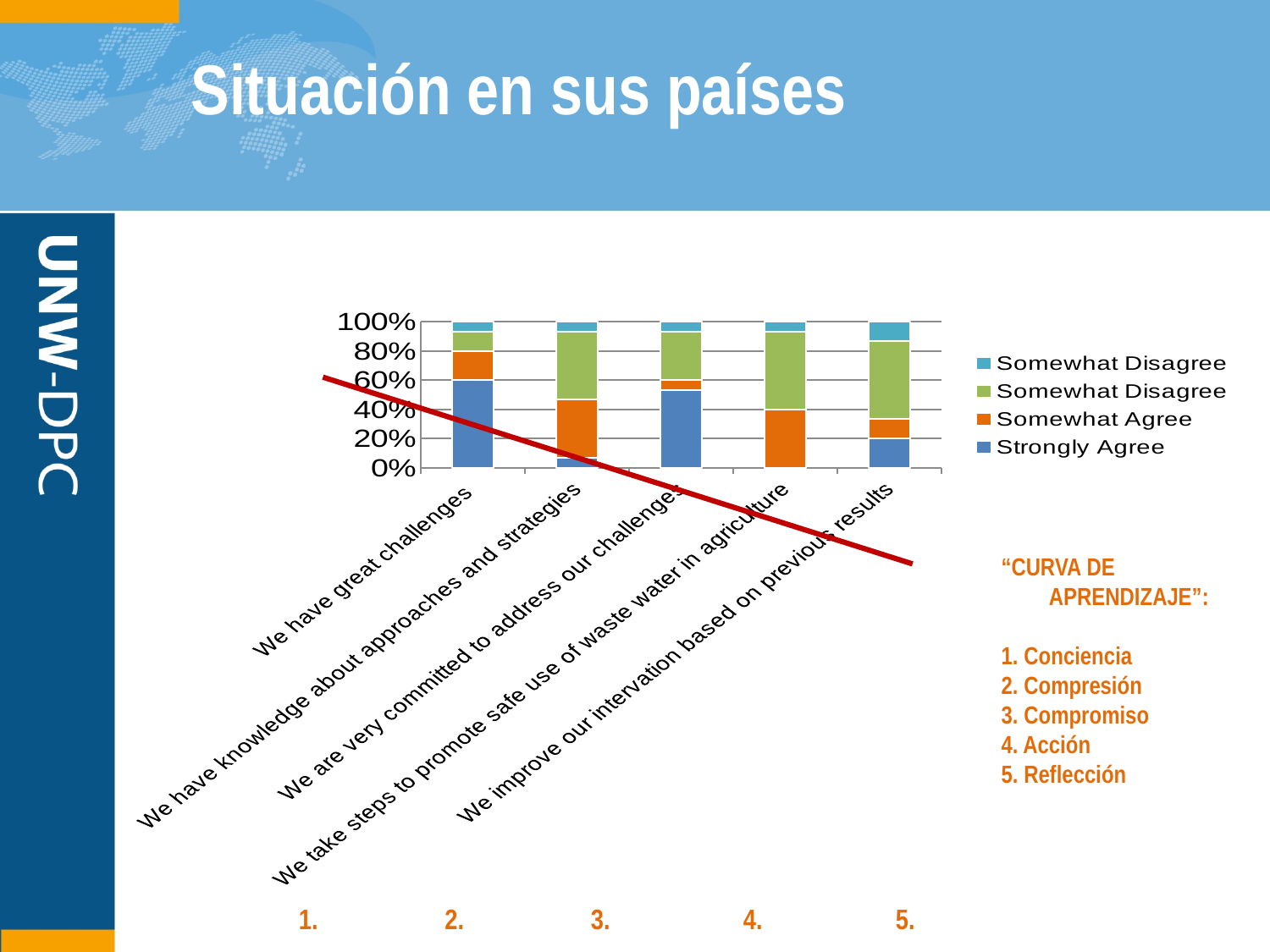
Which category has the smallest Strongly Agree share? We take steps to promote safe use of waste water in agriculture What is the top value shown on the chart's vertical axis? 100% Which category has the smallest Somewhat Agree share? We are very committed to address our challenges Is the Strongly Agree share for "We improve our intervation based on previous results" greater or less than 40%? less Is the Strongly Agree share for "We have knowledge about approaches and strategies" greater or less than 20%? less Is the Strongly Agree share for "We have great challenges" greater or less than 40%? greater Which has the larger Strongly Agree share: "We have great challenges" or "We have knowledge about approaches and strategies"? We have great challenges How many series does the chart's legend list? 4 How many categories (statements) are plotted along the x axis of the chart? 5 Which legend entry is shown in dark blue? Strongly Agree Which category has the largest Strongly Agree share? We have great challenges What kind of chart is shown on the slide? Stacked bar chart